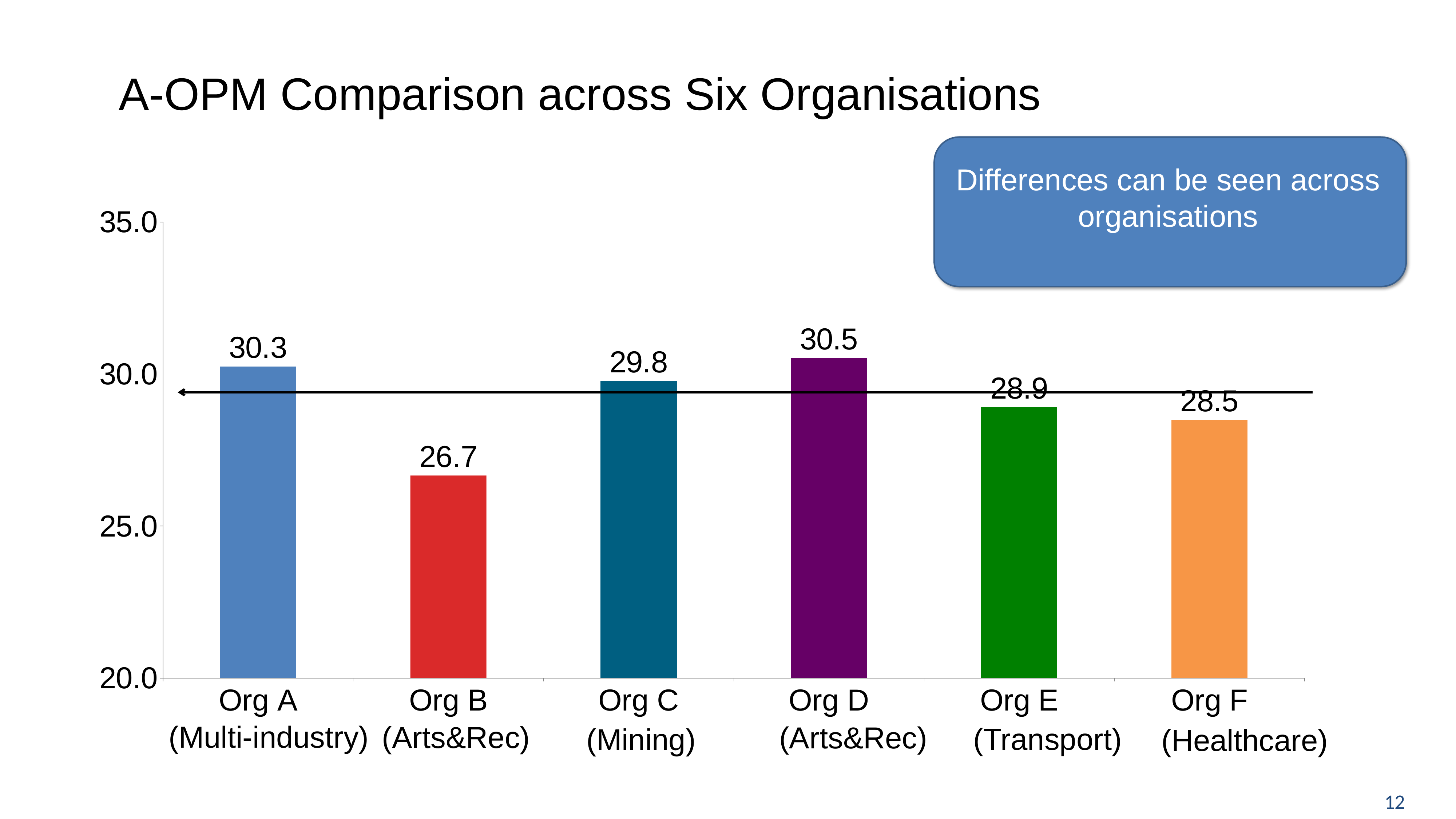
Which organisation has the highest value? Org D (Arts&Rec) Which is larger, the value for Org E (Transport) or Org F (Healthcare)? Org E (Transport) What is the title of the slide? A-OPM Comparison across Six Organisations Which organisation has the lowest value? Org B (Arts&Rec) What kind of chart is shown on the slide? bar chart What is the difference between the values for Org A and Org C? 0.5 What is the value for Org F (Healthcare)? 28.5 How many organisations are shown on the chart? 6 What is the value for Org B (Arts&Rec)? 26.7 What is the difference between the values for Org D and Org B? 3.8 What is the value for Org A (Multi-industry)? 30.3 Is the value for Org C (Mining) greater or less than 30.0? less